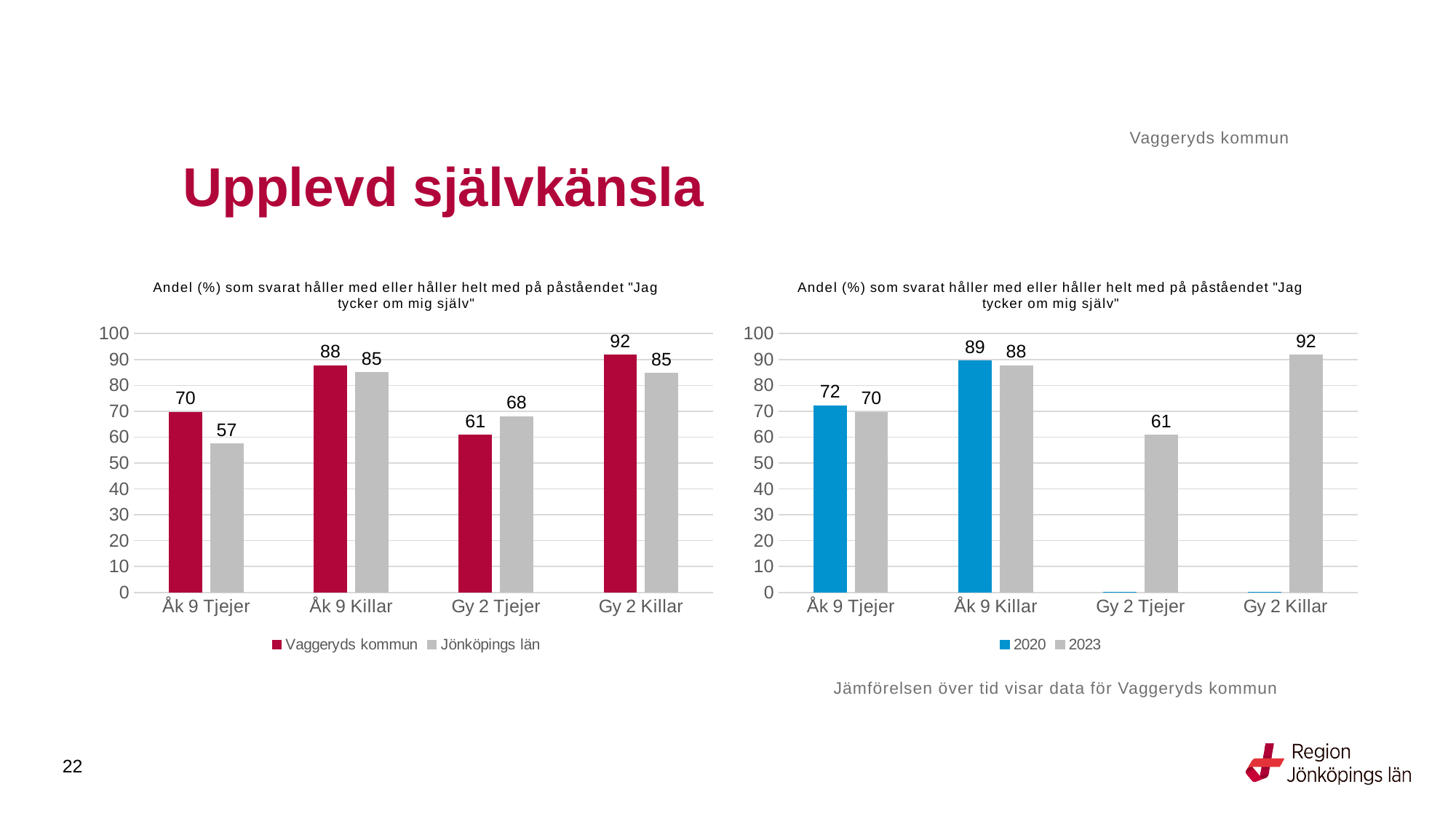
In the left chart, what is the value for Vaggeryds kommun for Åk 9 Tjejer? 70 In the right chart, what is the difference between 2020 and 2023 for Åk 9 Tjejer? 2 How many categories are shown on the x axis of the left chart? 4 In the right chart, what is the value for 2023 for Gy 2 Killar? 92 In the left chart, what is the difference between Vaggeryds kommun and Jönköpings län for Åk 9 Tjejer? 13 In the left chart, which category has the highest value for Vaggeryds kommun? Gy 2 Killar What kind of chart is the left chart? Bar chart In the left chart, what is the value for Jönköpings län for Gy 2 Tjejer? 68 How many series does the legend of the right chart list? 2 In the left chart, which is larger for Gy 2 Tjejer: Vaggeryds kommun or Jönköpings län? Jönköpings län In the right chart, what is the value for 2020 for Åk 9 Killar? 89 In the left chart, which category has the lowest value for Jönköpings län? Åk 9 Tjejer